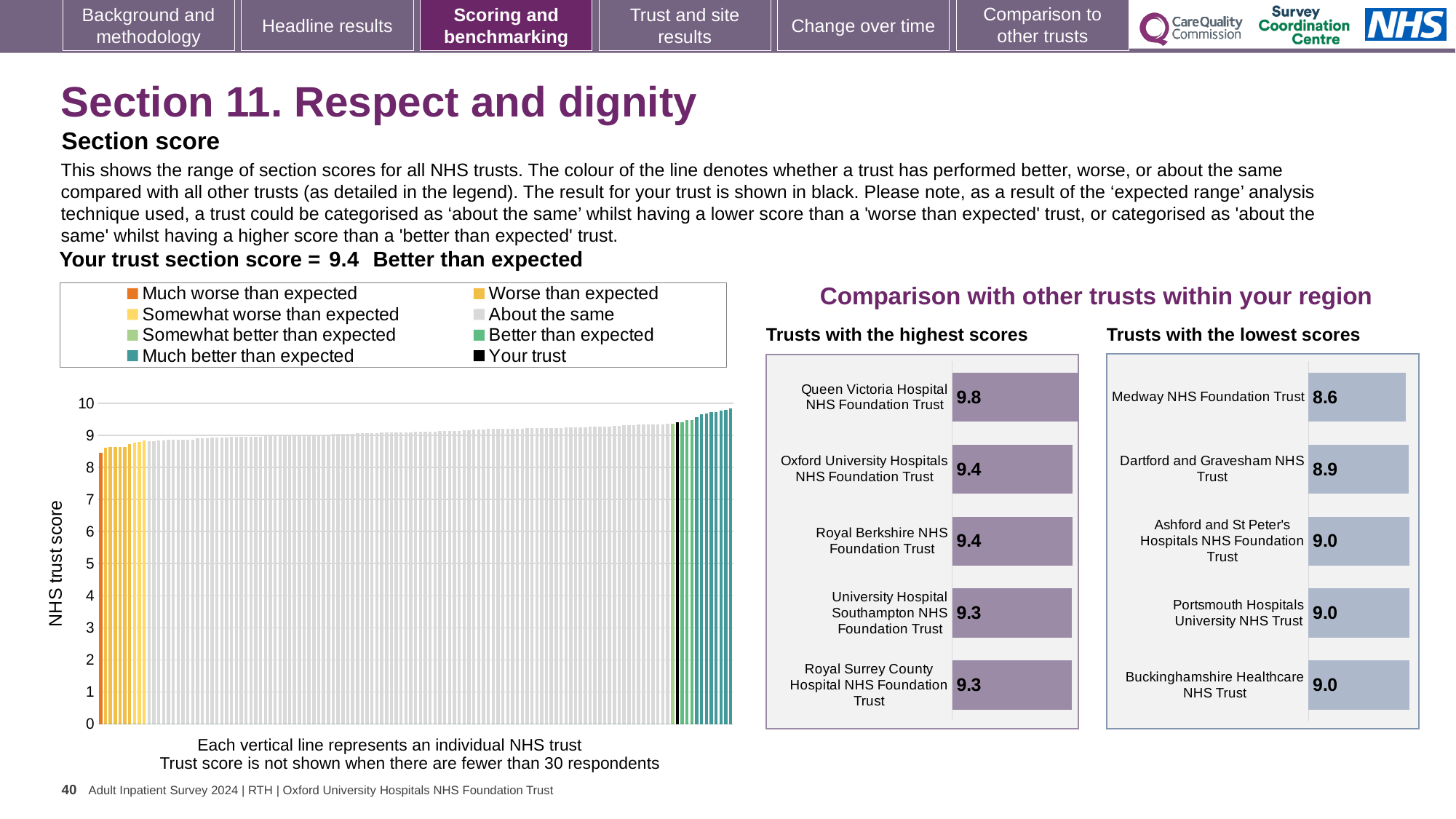
In the 'Trusts with the highest scores' chart, which trust has the highest score? Queen Victoria Hospital NHS Foundation Trust In the 'Trusts with the highest scores' chart, what is the score for Queen Victoria Hospital NHS Foundation Trust? 9.8 How many entries does the legend above the large chart on the left list? 8 In the 'Trusts with the highest scores' chart, what is the difference between the scores of Queen Victoria Hospital NHS Foundation Trust and Royal Surrey County Hospital NHS Foundation Trust? 0.5 In the 'Trusts with the lowest scores' chart, what is the difference between the scores of Dartford and Gravesham NHS Trust and Medway NHS Foundation Trust? 0.3 In the 'Trusts with the lowest scores' chart, which trust has the lowest score? Medway NHS Foundation Trust In the 'Trusts with the lowest scores' chart, which has the larger score: Medway NHS Foundation Trust or Dartford and Gravesham NHS Trust? Dartford and Gravesham NHS Trust In the 'Trusts with the highest scores' chart, how many trusts are listed? 5 What kind of chart is the large chart on the left showing NHS trust scores? Bar chart In the 'Trusts with the lowest scores' chart, what is the score for Portsmouth Hospitals University NHS Trust? 9.0 In the 'Trusts with the lowest scores' chart, what is the score for Medway NHS Foundation Trust? 8.6 In the large chart on the left, do the trust scores rise or fall from left to right? Rise